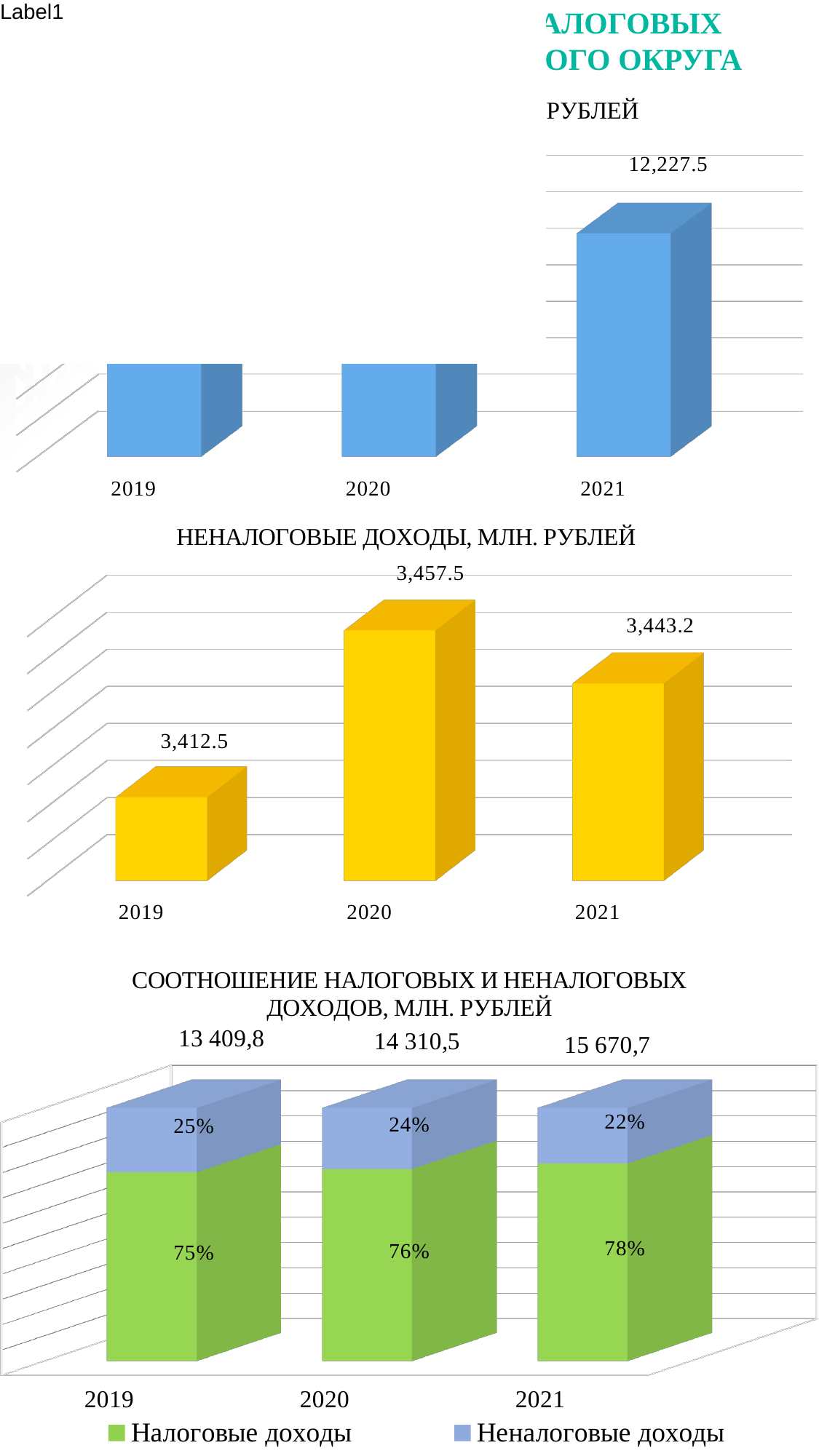
In the chart titled 'НЕНАЛОГОВЫЕ ДОХОДЫ, МЛН. РУБЛЕЙ', what is the value for 2019? 3,412.5 In the chart titled 'СООТНОШЕНИЕ НАЛОГОВЫХ И НЕНАЛОГОВЫХ ДОХОДОВ, МЛН. РУБЛЕЙ', does the share of 'Налоговые доходы' rise or fall from 2019 to 2021? rise In the chart titled 'НЕНАЛОГОВЫЕ ДОХОДЫ, МЛН. РУБЛЕЙ', what is the difference between the 2020 and 2019 values? 45.0 In the chart titled 'НЕНАЛОГОВЫЕ ДОХОДЫ, МЛН. РУБЛЕЙ', which year has the lowest value? 2019 In the chart titled 'СООТНОШЕНИЕ НАЛОГОВЫХ И НЕНАЛОГОВЫХ ДОХОДОВ, МЛН. РУБЛЕЙ', how many series does the legend list? 2 In the chart titled 'НЕНАЛОГОВЫЕ ДОХОДЫ, МЛН. РУБЛЕЙ', which year has the highest value? 2020 In the top chart, which year has the highest bar? 2021 In the chart titled 'НЕНАЛОГОВЫЕ ДОХОДЫ, МЛН. РУБЛЕЙ', what is the value for 2020? 3,457.5 In the chart titled 'СООТНОШЕНИЕ НАЛОГОВЫХ И НЕНАЛОГОВЫХ ДОХОДОВ, МЛН. РУБЛЕЙ', what percentage does 'Налоговые доходы' make up in 2020? 76% In the top chart, how many years are shown on the x axis? 3 In the chart titled 'СООТНОШЕНИЕ НАЛОГОВЫХ И НЕНАЛОГОВЫХ ДОХОДОВ, МЛН. РУБЛЕЙ', what is the total for 2021? 15 670,7 In the top chart, what is the value for 2021? 12,227.5